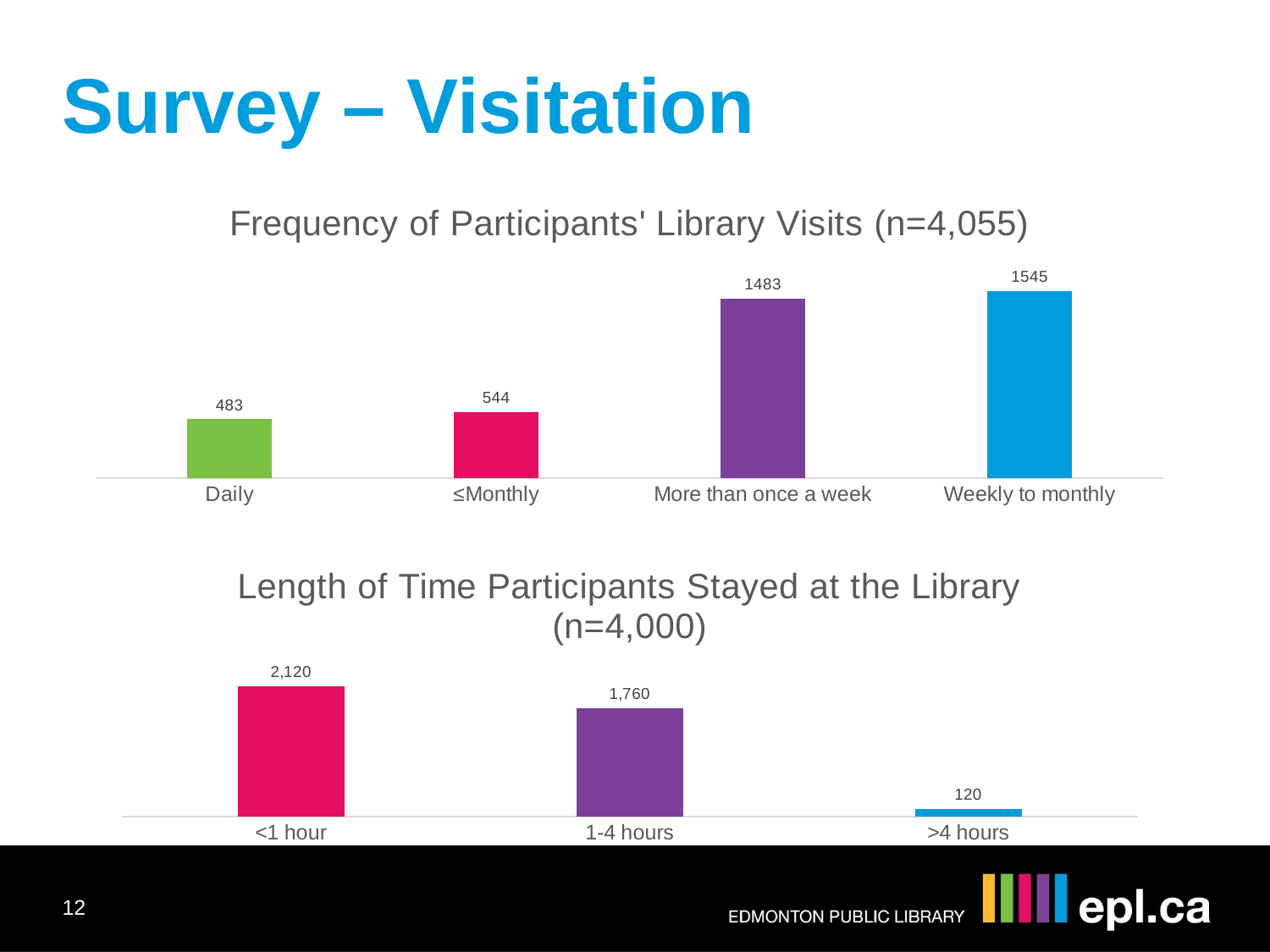
In the 'Length of Time Participants Stayed at the Library' chart, do the values rise or fall from left to right? fall In the 'Frequency of Participants' Library Visits' chart, which category has the highest value? Weekly to monthly In the 'Frequency of Participants' Library Visits' chart, what is the value for More than once a week? 1483 What type of chart is the 'Length of Time Participants Stayed at the Library' chart? bar chart In the 'Length of Time Participants Stayed at the Library' chart, which category has the highest value? <1 hour In the 'Length of Time Participants Stayed at the Library' chart, what is the value for >4 hours? 120 In the 'Frequency of Participants' Library Visits' chart, how many categories are shown? 4 In the 'Frequency of Participants' Library Visits' chart, which category has the lowest value? Daily In the 'Length of Time Participants Stayed at the Library' chart, what is the value for 1-4 hours? 1,760 In the 'Frequency of Participants' Library Visits' chart, what is the difference between the values for Weekly to monthly and More than once a week? 62 In the 'Length of Time Participants Stayed at the Library' chart, what is the difference between the values for <1 hour and 1-4 hours? 360 In the 'Frequency of Participants' Library Visits' chart, what is the value for Daily? 483